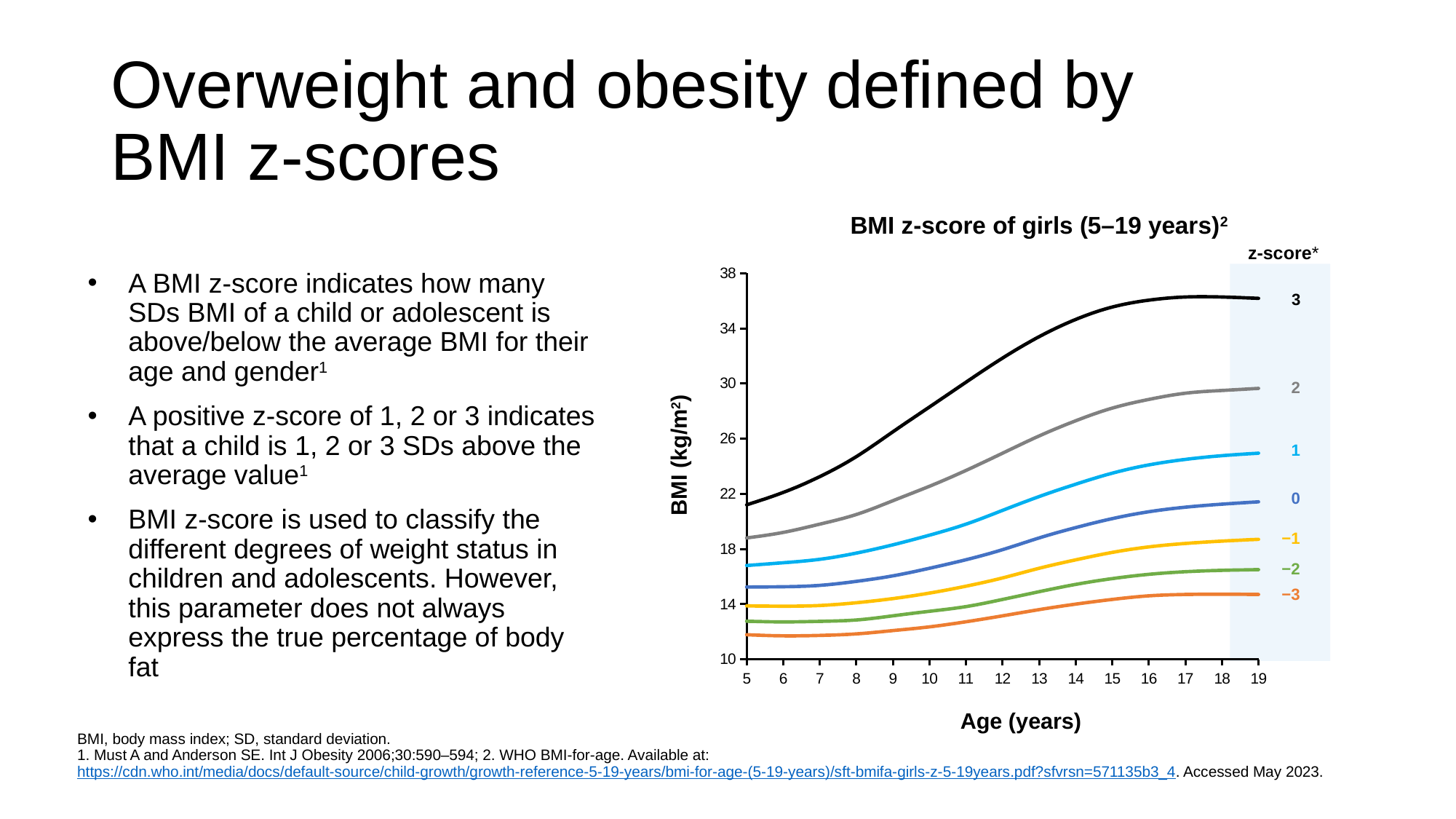
Is the BMI value for the z-score −3 line at age 19 greater or less than 18? less At age 19, which line has the higher BMI value: z-score 1 or z-score 0? z-score 1 Is the BMI value for the z-score 3 line at age 19 greater or less than 34? greater What is the label of the y-axis of the chart? BMI (kg/m²) What kind of chart is shown on the slide? Line chart What is the title of the chart? BMI z-score of girls (5–19 years) Is the BMI value for the z-score 0 line at age 5 greater or less than 18? less Which z-score line has the lowest BMI values across all ages? −3 Do the BMI values for the z-score 3 line rise or fall as age increases from 5 to 19 years? Rise Which z-score line has the highest BMI values across all ages? 3 How many z-score lines are plotted on the chart? 7